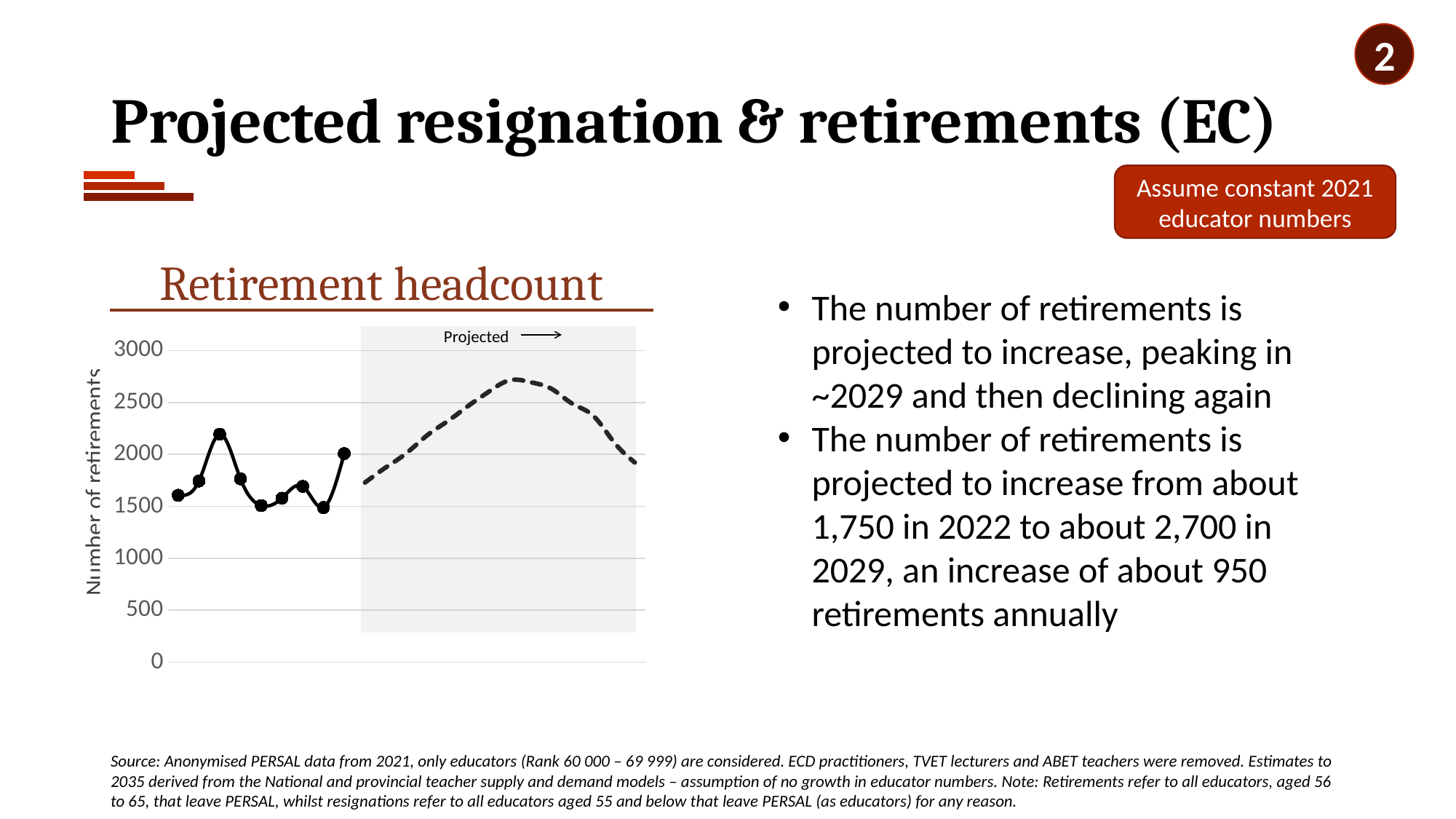
What kind of chart is shown under the title "Retirement headcount"? line chart What is the label on the vertical axis of the Retirement headcount chart? Number of retirements In the Retirement headcount chart, is the peak of the dashed projected line higher or lower than the highest point of the solid line? higher In the Retirement headcount chart, is the last point of the dashed projected line greater or less than 1500? greater In the Retirement headcount chart, is the first point on the solid line greater or less than 1500? greater How many data points (markers) are plotted on the solid line of the Retirement headcount chart? 9 In the Retirement headcount chart, is the peak of the dashed projected line greater or less than 3000? less In the Retirement headcount chart, does the dashed projected line rise and then fall, or fall and then rise, moving left to right? rise and then fall What is the title of the chart on the slide? Retirement headcount What is the highest value shown on the vertical axis of the Retirement headcount chart? 3000